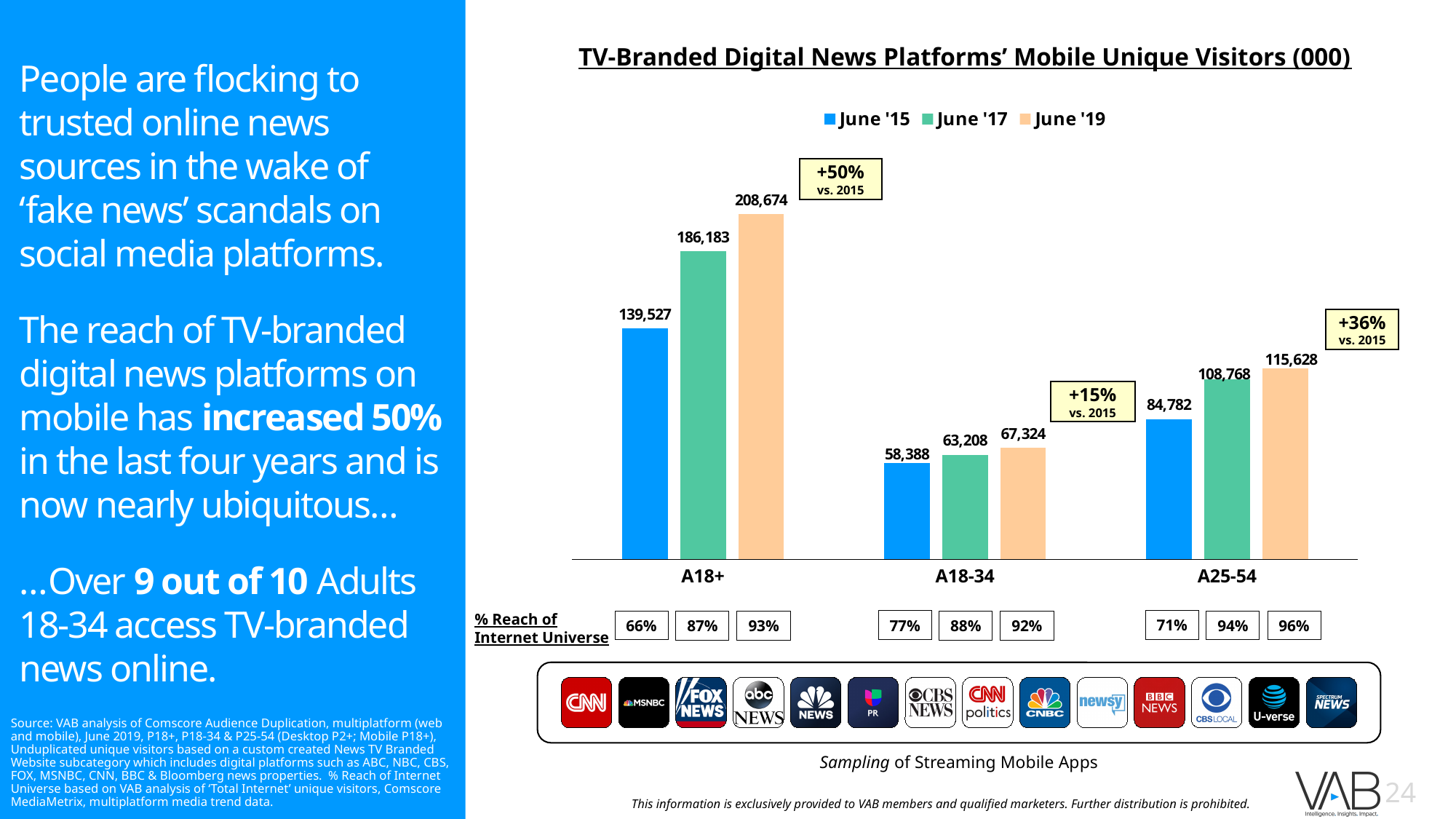
Which is larger: the June '17 value for A18-34 or the June '15 value for A25-54? June '15 value for A25-54 What kind of chart is this? Bar chart How many series does the legend list? 3 What is the June '19 value for A18+? 208,674 What is the difference between the June '19 and June '17 values for A25-54? 6,860 What is the difference between the June '19 and June '15 values for A18+? 69,147 Do the values for A25-54 rise or fall from June '15 to June '19? Rise What is the June '15 value for A18-34? 58,388 What is the June '17 value for A25-54? 108,768 Which age group has the lowest June '15 value? A18-34 Which age group has the highest June '19 value? A18+ How many age groups are shown on the x axis? 3